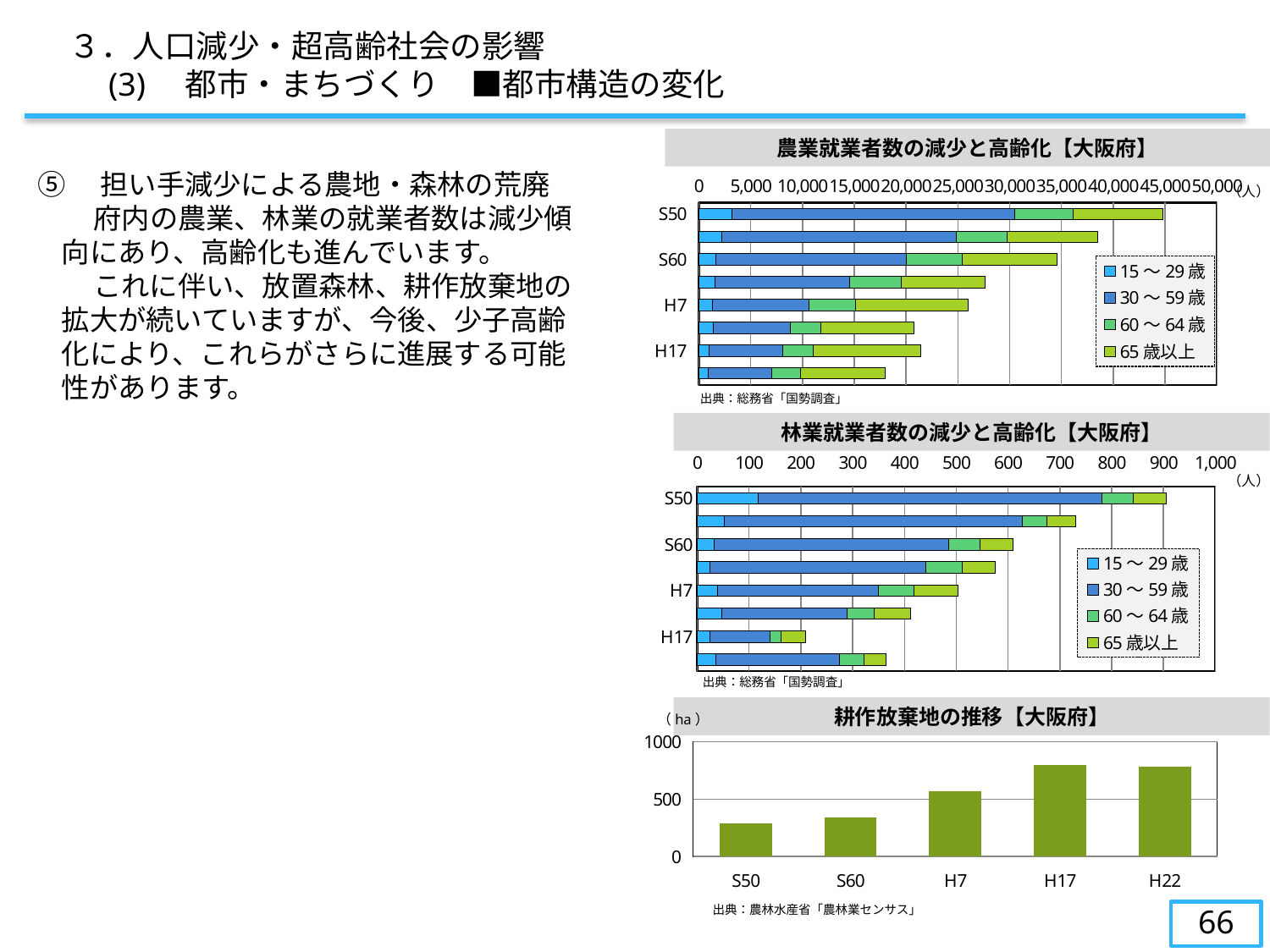
What kind of chart is the chart titled 耕作放棄地の推移【大阪府】? bar chart In the chart titled 耕作放棄地の推移【大阪府】, is the value for S50 greater or less than 500? less In the chart titled 林業就業者数の減少と高齢化【大阪府】, what is the last entry listed in the legend? 65歳以上 In the chart titled 耕作放棄地の推移【大阪府】, is the value for H17 greater or less than 500? greater In the chart titled 耕作放棄地の推移【大阪府】, which is larger, the value for S60 or the value for H7? H7 In the chart titled 耕作放棄地の推移【大阪府】, which category has the lowest value? S50 In the chart titled 林業就業者数の減少と高齢化【大阪府】, is the total for H17 greater or less than 300? less In the chart titled 耕作放棄地の推移【大阪府】, how many categories are shown on the x axis? 5 In the chart titled 耕作放棄地の推移【大阪府】, do the values generally rise or fall from S50 to H22? rise In the chart titled 農業就業者数の減少と高齢化【大阪府】, which is larger, the total for S50 or the total for H17? S50 In the chart titled 農業就業者数の減少と高齢化【大阪府】, how many series does the legend list? 4